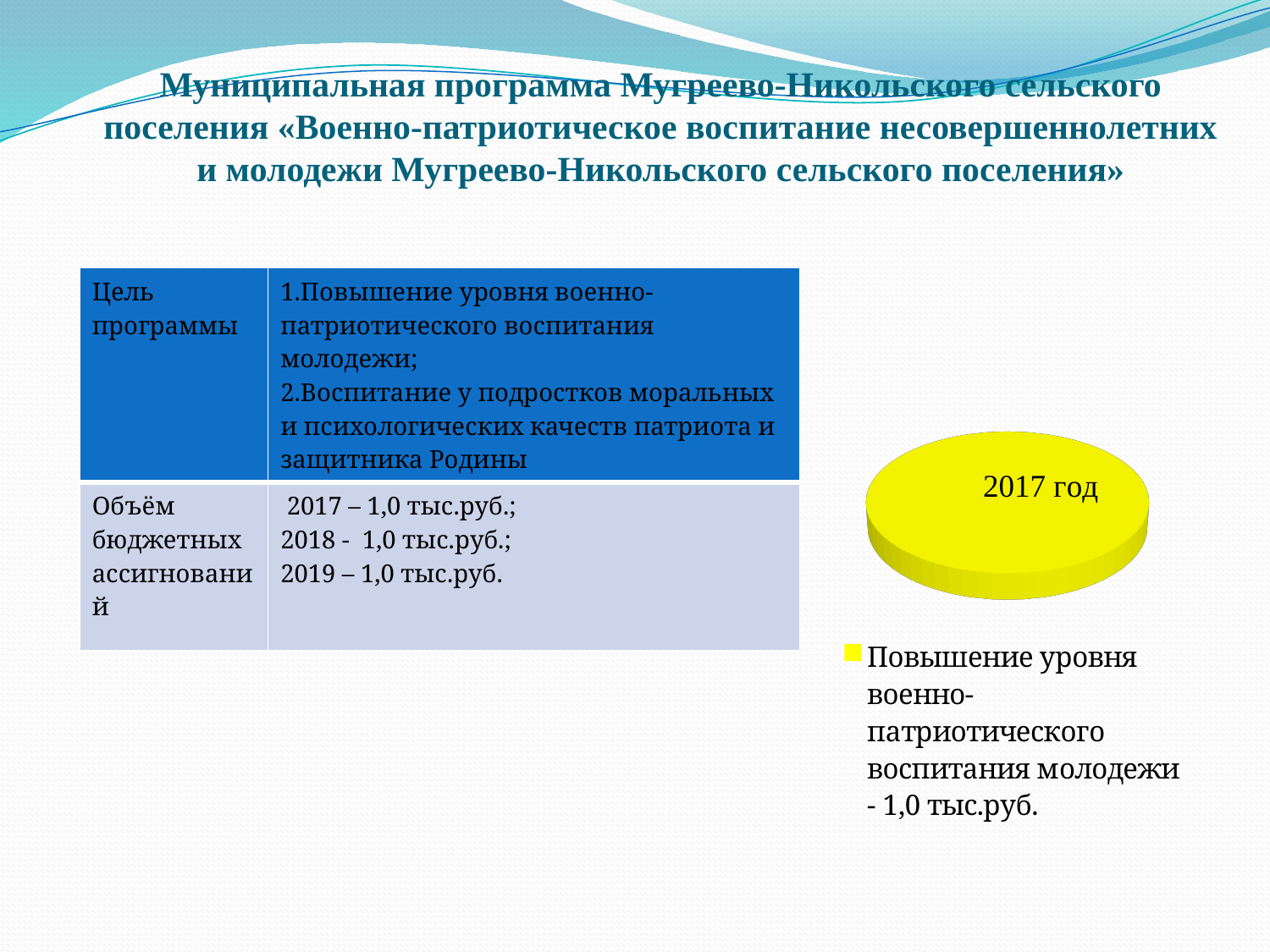
How many slices does the pie chart contain? 1 What share of the pie does the slice labelled "2017 год" represent? 100% What colour is the slice of the pie chart? yellow According to the legend, what amount is given for "Повышение уровня военно-патриотического воспитания молодежи"? 1,0 тыс.руб. What label is printed on the pie chart's slice? 2017 год How many entries does the legend of the pie chart list? 1 What kind of chart is shown on the right side of the slide? pie chart